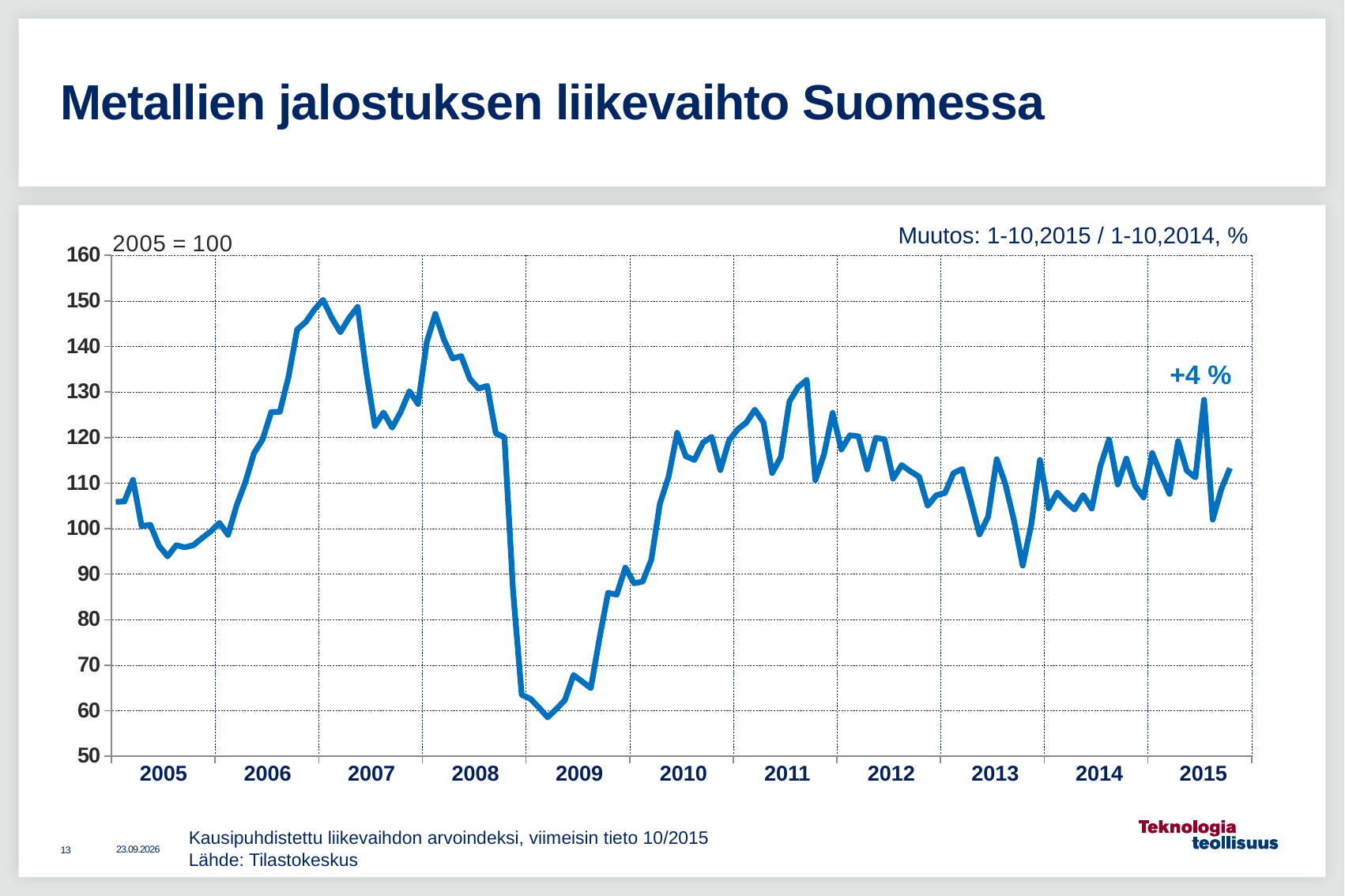
Is the highest value reached in 2006 greater or less than 140? greater Do the values rise or fall between the start of 2005 and mid-2006? rise What is the title of the chart on the slide? Metallien jalostuksen liikevaihto Suomessa What base-year note is printed at the top left of the chart? 2005 = 100 Do the values rise or fall between mid-2008 and the start of 2009? fall What kind of chart is shown on the slide? line chart Is the lowest value reached in 2013 greater or less than 100? less Is the value at the start of 2005 greater or less than 100? greater How many years are labelled on the x axis of the chart? 11 What percentage change is printed next to the end of the line in the chart? +4 %